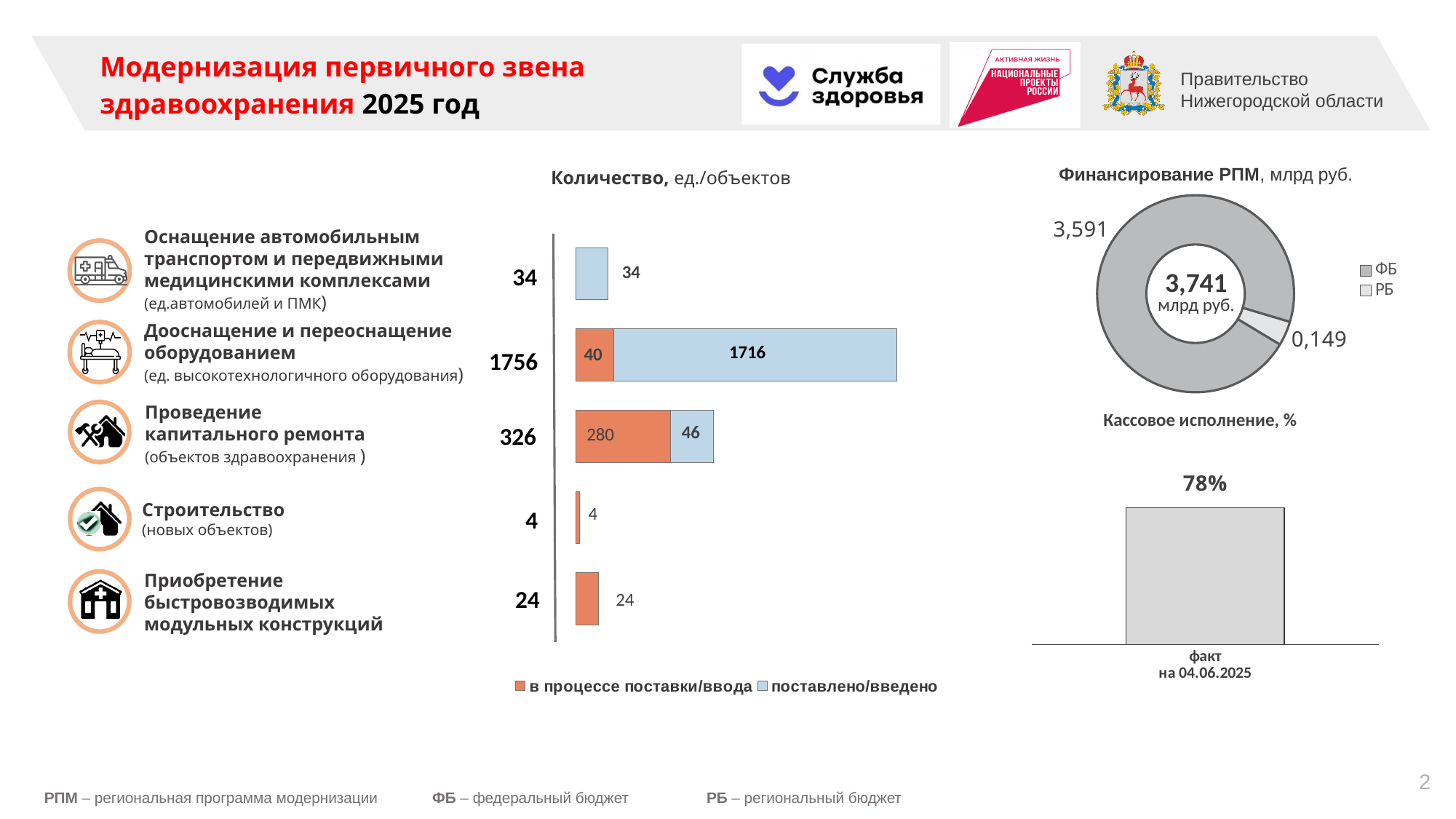
In the chart titled "Количество, ед./объектов", which category has the highest total value? Дооснащение и переоснащение оборудованием In the chart titled "Количество, ед./объектов", which category has the lowest total value? Строительство In the chart titled "Количество, ед./объектов", what is the "в процессе поставки/ввода" value for "Дооснащение и переоснащение оборудованием"? 40 In the chart titled "Кассовое исполнение, %", what is the value for "факт на 04.06.2025"? 78% In the chart titled "Финансирование РПМ, млрд руб.", which is larger, "ФБ" or "РБ"? ФБ In the chart titled "Количество, ед./объектов", what is the total value for "Проведение капитального ремонта"? 326 What kind of chart is the one titled "Количество, ед./объектов"? Bar chart In the chart titled "Количество, ед./объектов", how many series does the legend list? 2 In the chart titled "Финансирование РПМ, млрд руб.", what is the value for "ФБ"? 3,591 In the chart titled "Количество, ед./объектов", what is the difference between the "в процессе поставки/ввода" and "поставлено/введено" values for "Проведение капитального ремонта"? 234 In the chart titled "Количество, ед./объектов", how many categories are shown? 5 In the chart titled "Количество, ед./объектов", what is the "поставлено/введено" value for "Проведение капитального ремонта"? 46